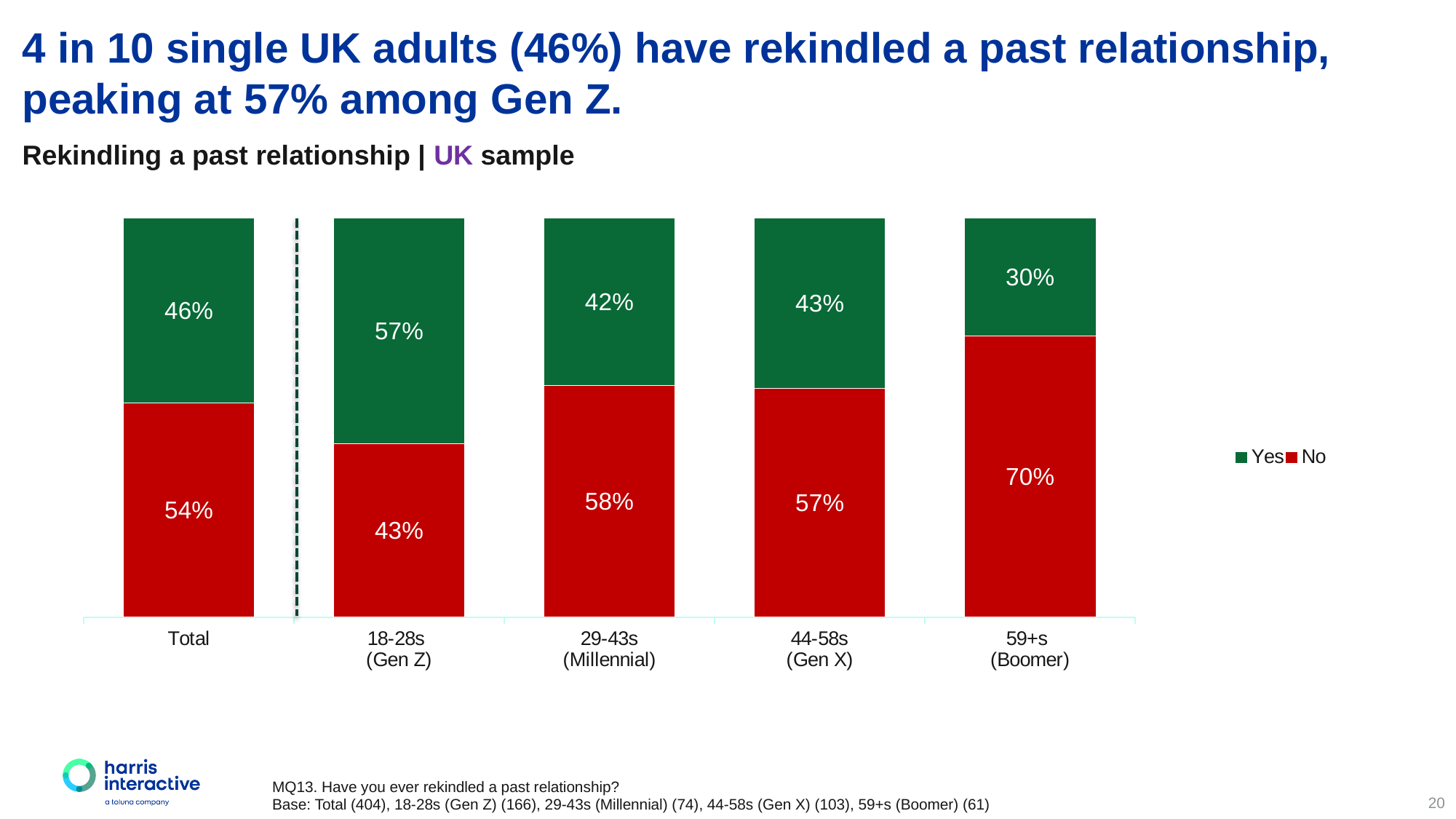
What is the difference between the Yes values for 18-28s (Gen Z) and 59+s (Boomer)? 27 percentage points Which colour represents the No series in the legend? Red Which age group has the highest Yes value? 18-28s (Gen Z) What is the No value for the 59+s (Boomer) group? 70% Which is larger: the No value for 44-58s (Gen X) or the No value for 18-28s (Gen Z)? 44-58s (Gen X) What is the Yes value for the 29-43s (Millennial) group? 42% What percentage of the Total group answered Yes to rekindling a past relationship? 46% How many series does the legend list? 2 How many categories are shown on the x axis? 5 What is the total of the stacked bar for 44-58s (Gen X)? 100% Which age group has the lowest Yes value? 59+s (Boomer) What kind of chart is shown on the slide? Stacked bar chart